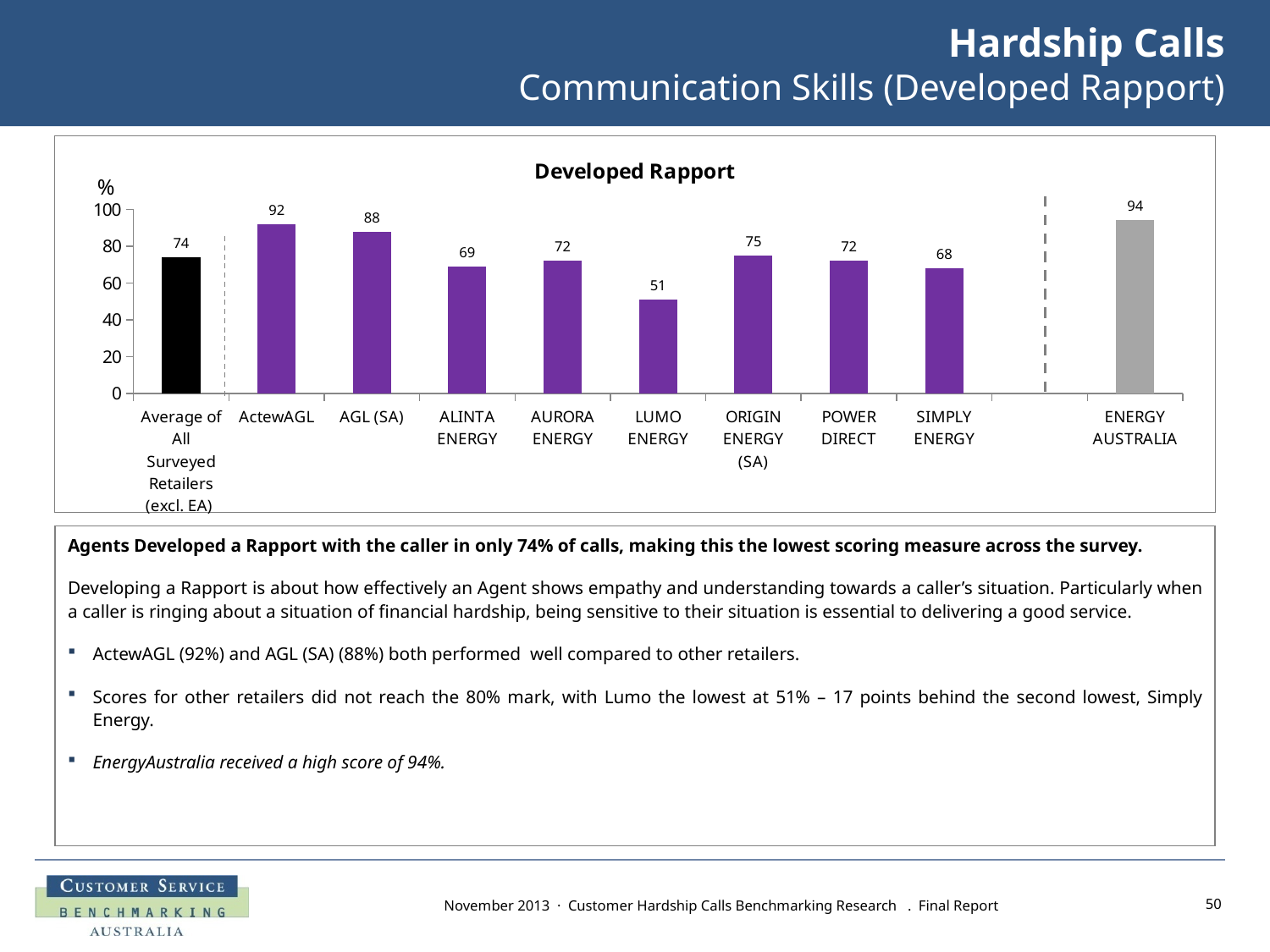
Which category has the highest value in the chart? ENERGY AUSTRALIA What is the Developed Rapport score for ActewAGL? 92 What is the difference between the values for LUMO ENERGY and SIMPLY ENERGY? 17 What is the value shown for LUMO ENERGY? 51 What is the title of the chart? Developed Rapport Which has a higher value, ORIGIN ENERGY (SA) or ALINTA ENERGY? ORIGIN ENERGY (SA) How many bars are plotted in the chart? 10 What is the difference between the values for ActewAGL and AGL (SA)? 4 What is the value shown for ENERGY AUSTRALIA? 94 What type of chart is shown on the slide? Bar chart What is the value for Average of All Surveyed Retailers (excl. EA)? 74 Which category has the lowest value in the chart? LUMO ENERGY